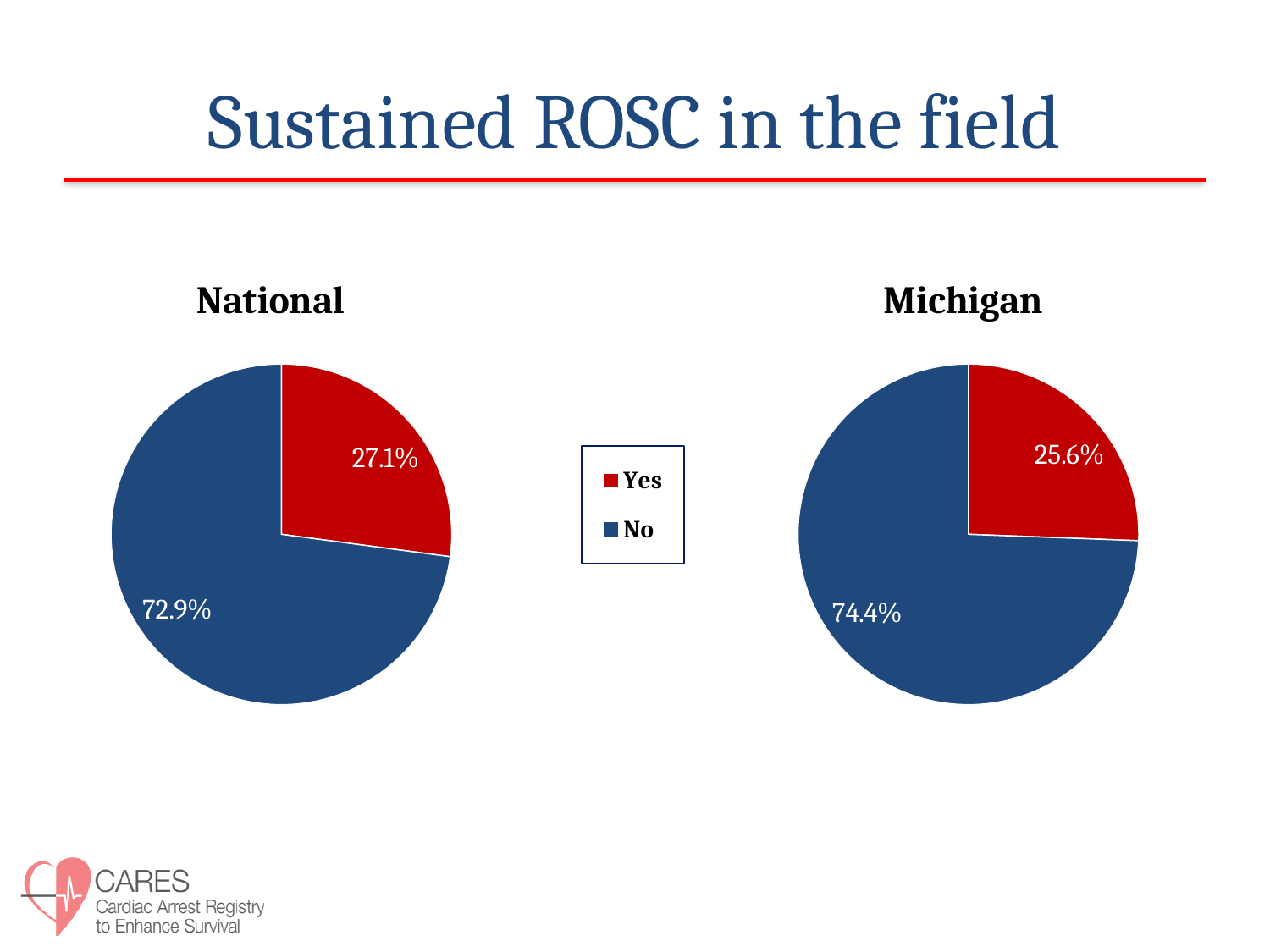
Is the Yes share larger in the National pie chart or the Michigan pie chart? National What colour represents Yes in the pie charts? Red In the Michigan pie chart, which category has the largest slice? No What kind of chart is used for the National data? Pie chart In the National pie chart, which category has the smallest slice? Yes How many slices does the Michigan pie chart have? 2 In the National pie chart, what percentage is labelled for No? 72.9% In the Michigan pie chart, what percentage is labelled for No? 74.4% How many entries does the legend list? 2 In the Michigan pie chart, what percentage is labelled for Yes? 25.6% In the National pie chart, what percentage is labelled for Yes? 27.1% What is the difference between the No share in the Michigan pie chart and the No share in the National pie chart? 1.5%